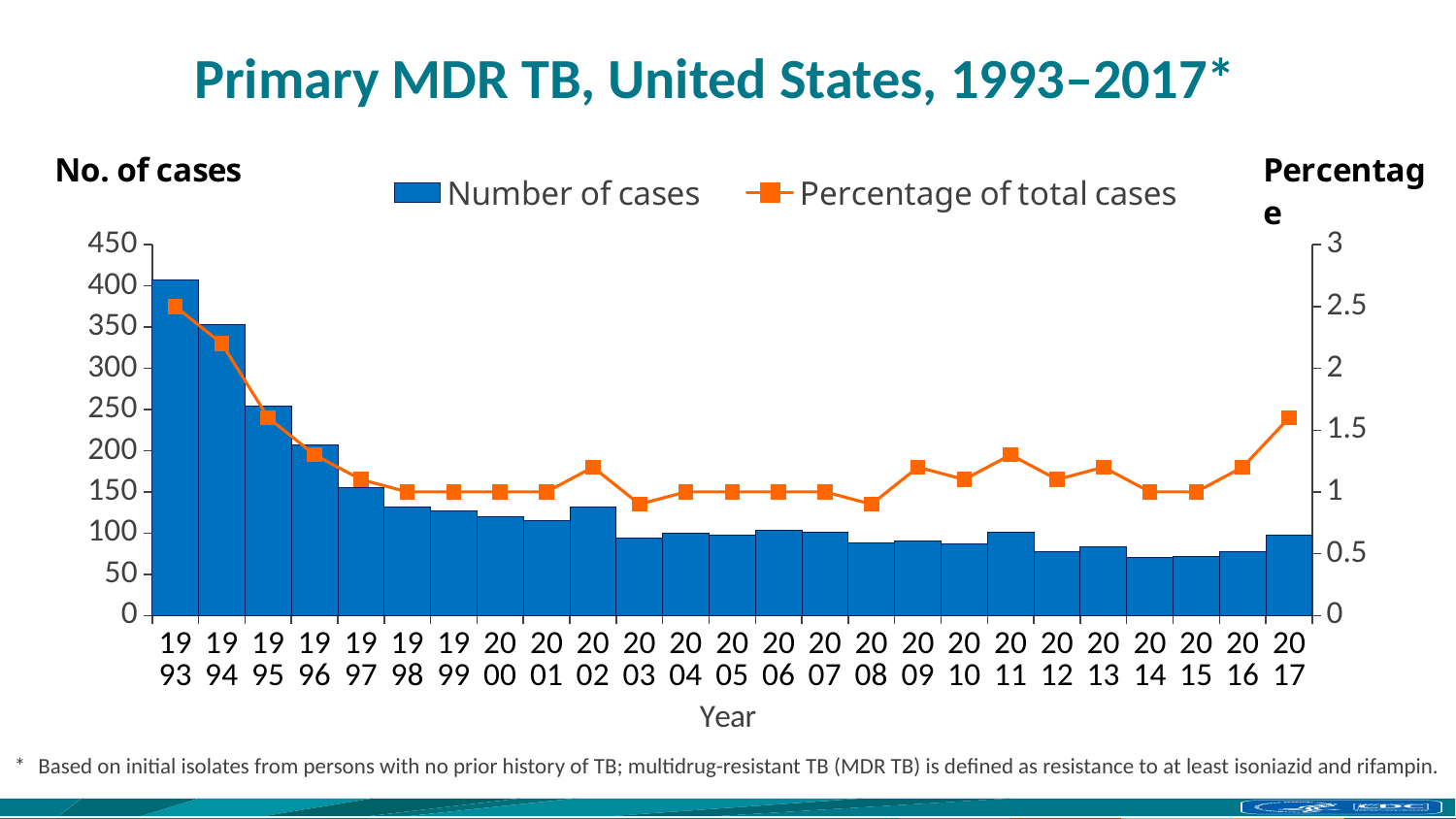
Which year has more cases, 2002 or 2003? 2002 Is the percentage of total cases for 1993 greater or less than 2? greater Is the number of cases for 2017 greater or less than 150? less Is the percentage of total cases for 2017 greater or less than 1? greater Overall, does the number of cases rise or fall from 1993 to 2017? Fall Which year has the highest number of cases? 1993 What kind of chart is shown on the slide? A combination bar and line chart Which year has the highest percentage of total cases? 1993 How many years are shown on the x axis? 25 What is the label of the left vertical axis? No. of cases How many series does the legend list? 2